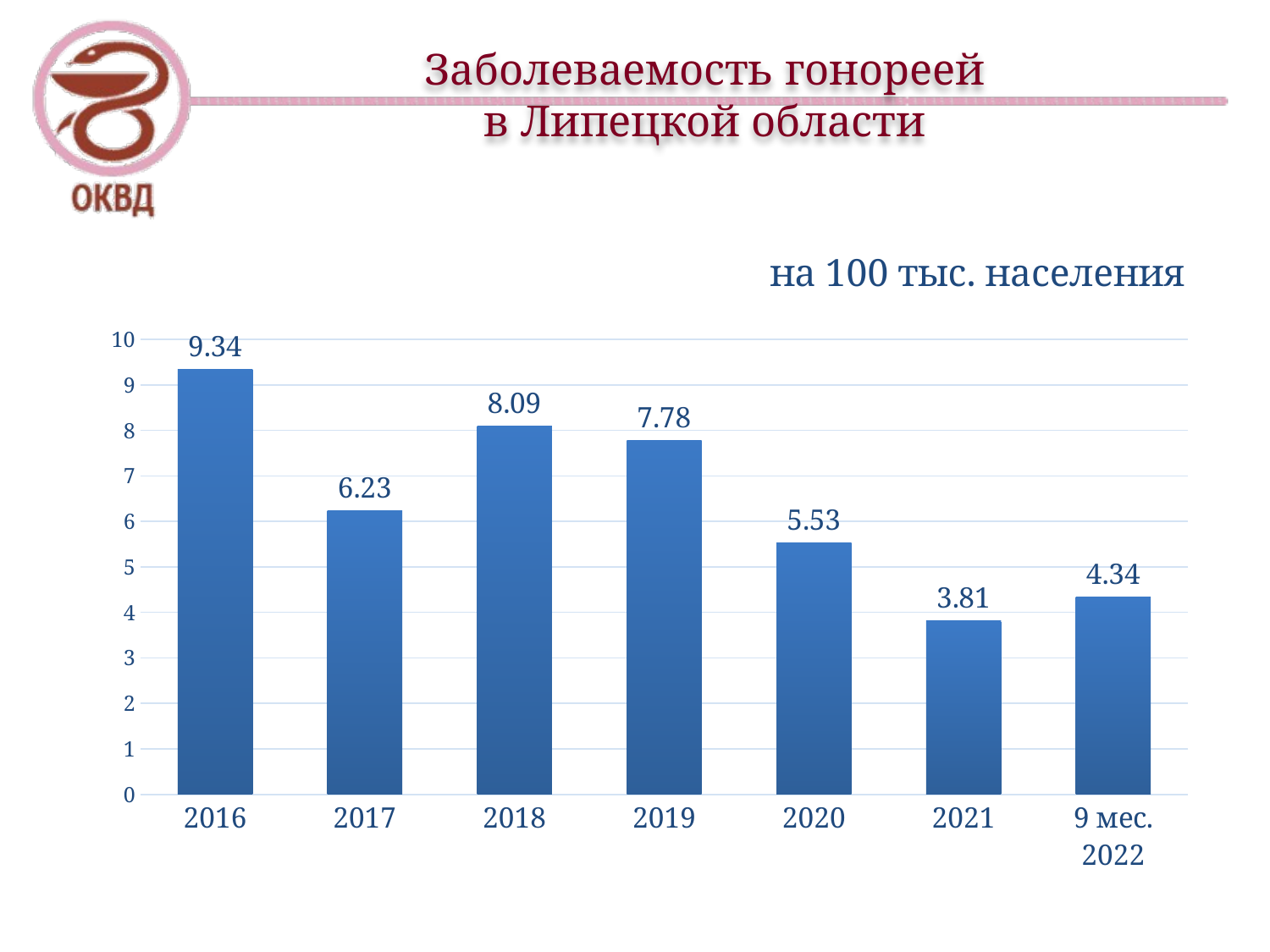
What is the difference between the values for 2020 and 2021? 1.72 What is the value shown for 2019? 7.78 Which is larger, the value for 2018 or the value for 2019? 2018 Is the value for 2020 greater or less than 6? less Which year has the highest incidence value? 2016 What kind of chart is shown on the slide? bar chart How many categories are shown on the x axis? 7 What unit is stated above the chart for the values? на 100 тыс. населения What is the difference between the values for 2016 and 2017? 3.11 What is the gonorrhea incidence value for 2016? 9.34 Which category has the lowest incidence value? 2021 What is the value shown for 9 мес. 2022? 4.34